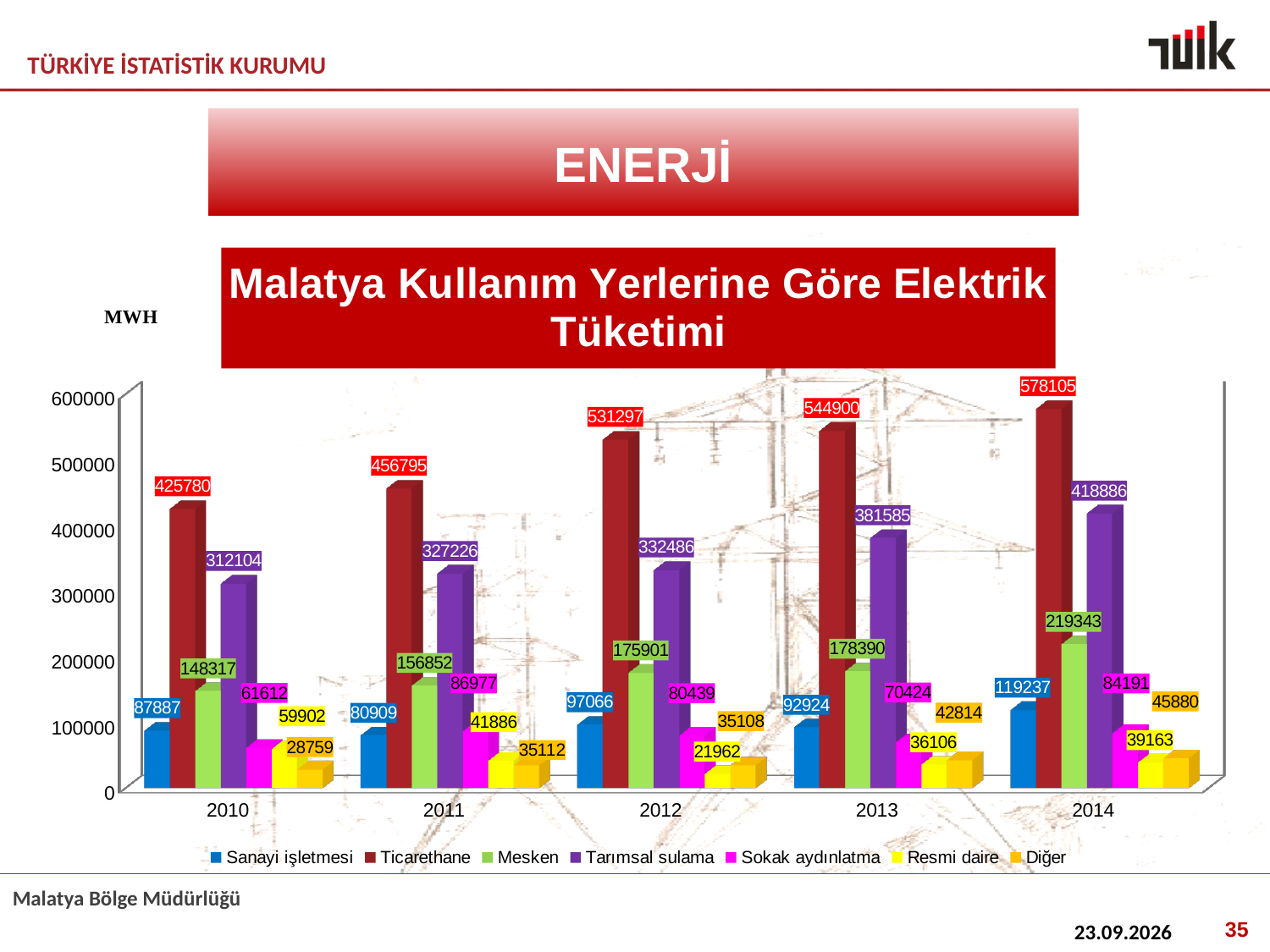
What is the value for Sanayi işletmesi in 2011? 80909 What is the title of the chart? Malatya Kullanım Yerlerine Göre Elektrik Tüketimi What is the value for Mesken in 2013? 178390 In which year is the Sanayi işletmesi value lowest? 2011 What is the value for Tarımsal sulama in 2012? 332486 What is the value for Ticarethane in 2014? 578105 Does the Ticarethane value rise or fall from 2010 to 2014? rise What type of chart is shown on the slide? bar chart What is the difference between the Ticarethane values in 2014 and 2010? 152325 How many series does the legend list? 7 In which year is the Ticarethane value highest? 2014 How many years are shown on the x axis? 5